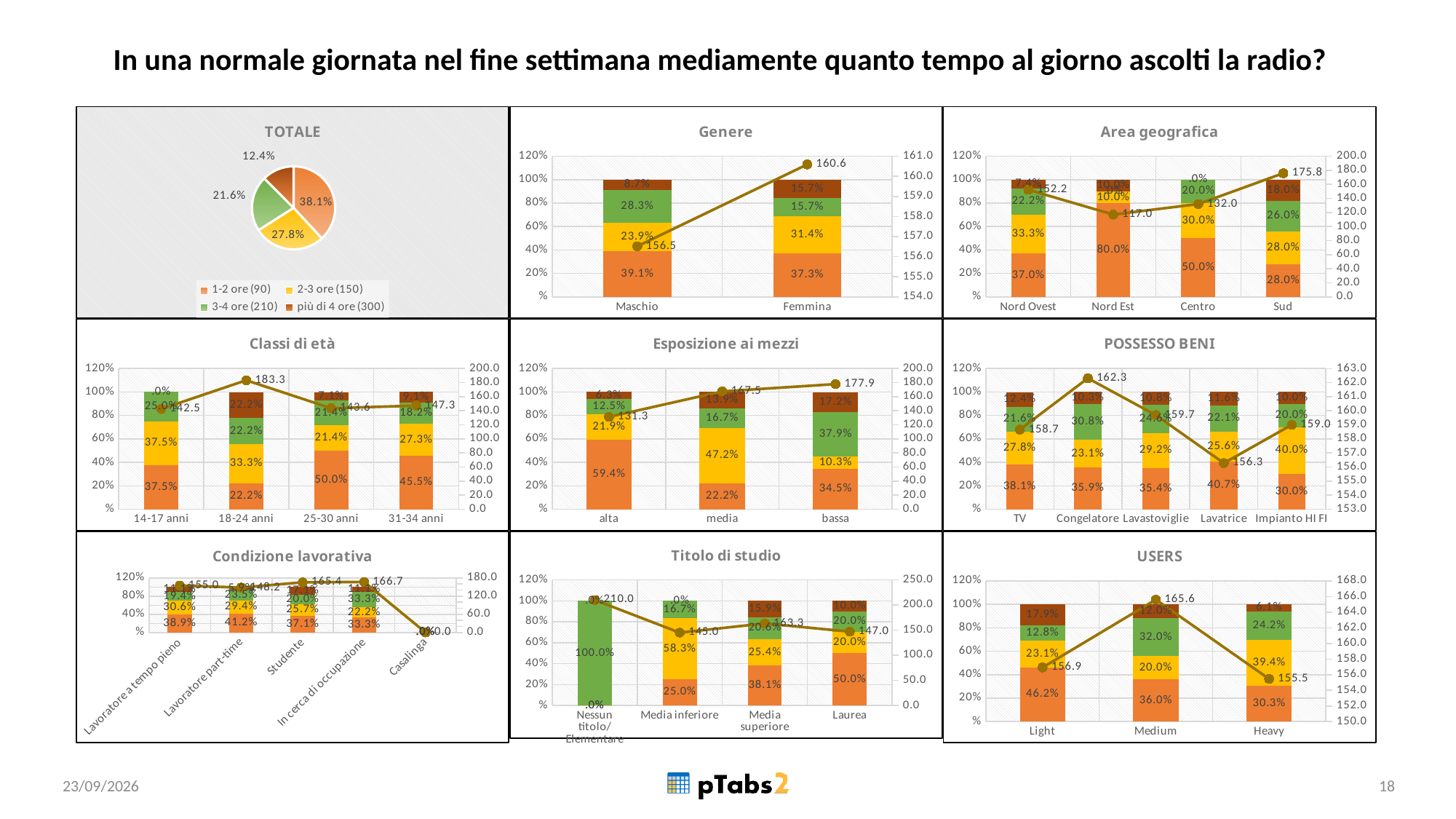
In the Area geografica chart, which category has the highest line value? Sud How many entries does the legend of the TOTALE pie chart list? 4 In the Titolo di studio chart, what is the line value for Nessun titolo/Elementare? 210.0 In the POSSESSO BENI chart, which has the larger line value, Congelatore or Lavatrice? Congelatore In the TOTALE pie chart, what share is shown for the 1-2 ore (90) slice? 38.1% In the Classi di età chart, what is the difference between the line values for 18-24 anni and 14-17 anni? 40.8 In the Genere chart, what is the line value for Femmina? 160.6 In the USERS chart, what is the 2-3 ore (150) percentage for Heavy? 39.4% In the Area geografica chart, what is the 1-2 ore (90) percentage for Nord Est? 80.0% In the POSSESSO BENI chart, how many categories are shown on the x axis? 5 What kind of chart is the TOTALE chart? Pie chart In the Esposizione ai mezzi chart, which category has the lowest line value? alta